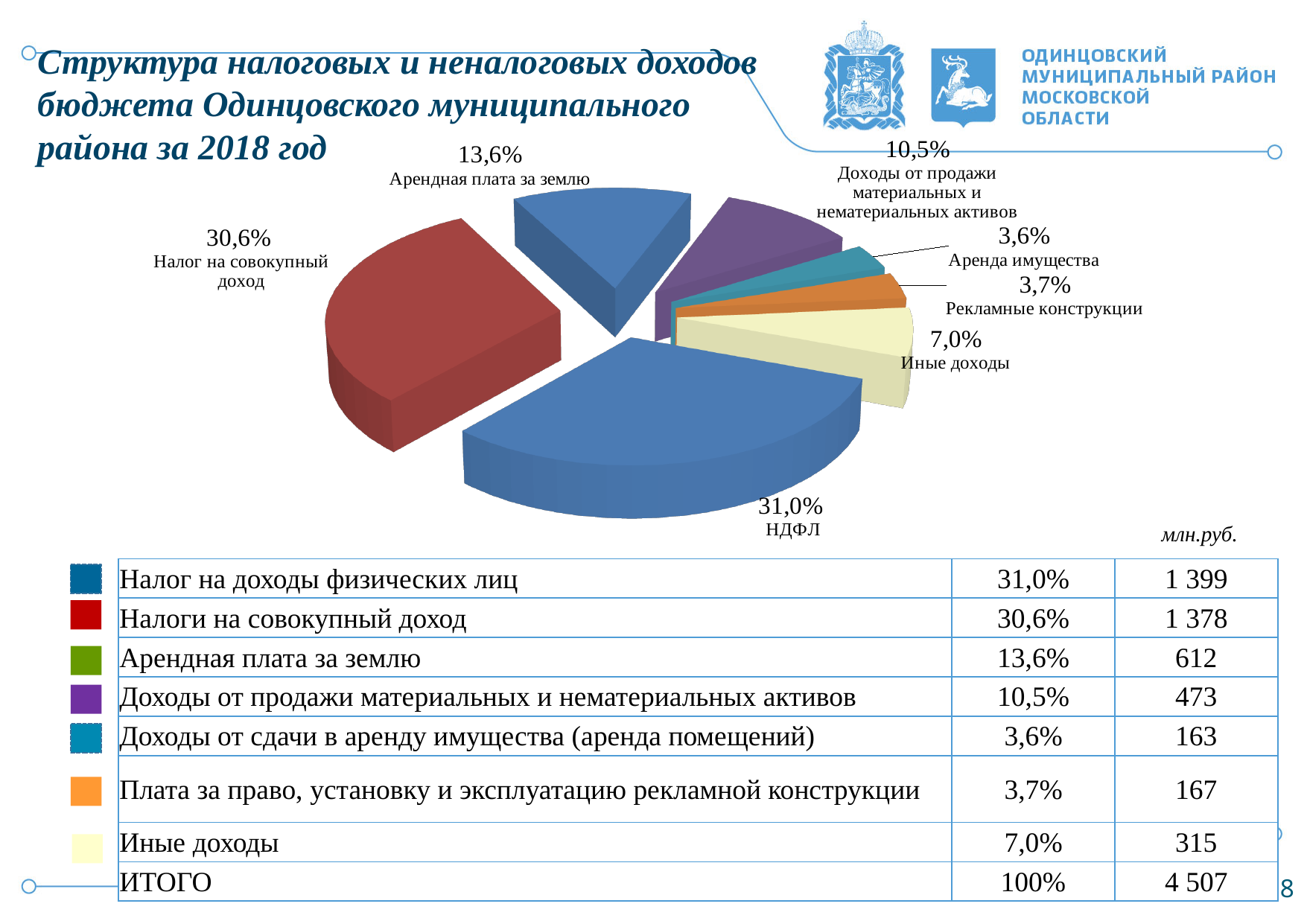
What percentage is shown for Налог на совокупный доход? 30,6% Which slice of the pie has the smallest share? Аренда имущества What percentage is shown for Арендная плата за землю? 13,6% What type of chart is shown on the slide? pie chart What percentage is shown for Иные доходы? 7,0% What is the difference in percentage points between НДФЛ and Налог на совокупный доход? 0,4% What share of the pie does НДФЛ account for? 31,0% How many slices does the pie chart have? 7 What is the difference in percentage points between Иные доходы and Рекламные конструкции? 3,3% Which slice of the pie has the largest share? НДФЛ What percentage is shown for Доходы от продажи материальных и нематериальных активов? 10,5% Which is larger: Рекламные конструкции or Аренда имущества? Рекламные конструкции